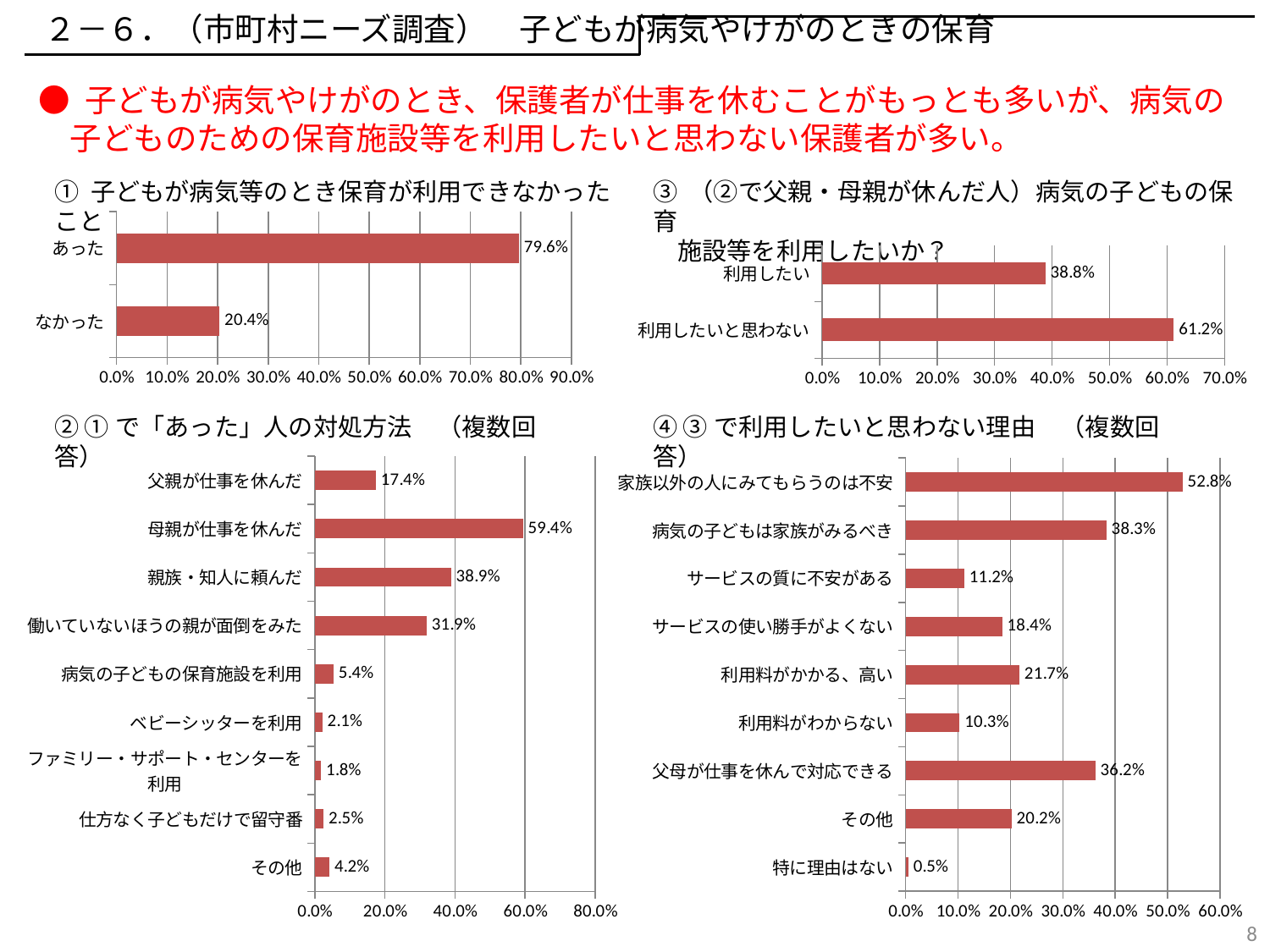
In chart ② (bottom-left), what is the value for 親族・知人に頼んだ? 38.9% In chart ① (top-left), what is the value for あった? 79.6% In chart ④ (bottom-right), what is the value for 父母が仕事を休んで対応できる? 36.2% In chart ② (bottom-left), which category has the lowest value? ファミリー・サポート・センターを利用 In chart ③ (top-right), which is larger, 利用したい or 利用したいと思わない? 利用したいと思わない In chart ③ (top-right), what is the value for 利用したいと思わない? 61.2% What type of chart is chart ④ (bottom-right)? Bar chart In chart ② (bottom-left), how many categories are shown? 9 In chart ① (top-left), what is the difference between あった and なかった? 59.2% In chart ② (bottom-left), which category has the highest value? 母親が仕事を休んだ In chart ④ (bottom-right), what is the difference between 利用料がかかる、高い and 利用料がわからない? 11.4% In chart ④ (bottom-right), which category has the highest value? 家族以外の人にみてもらうのは不安